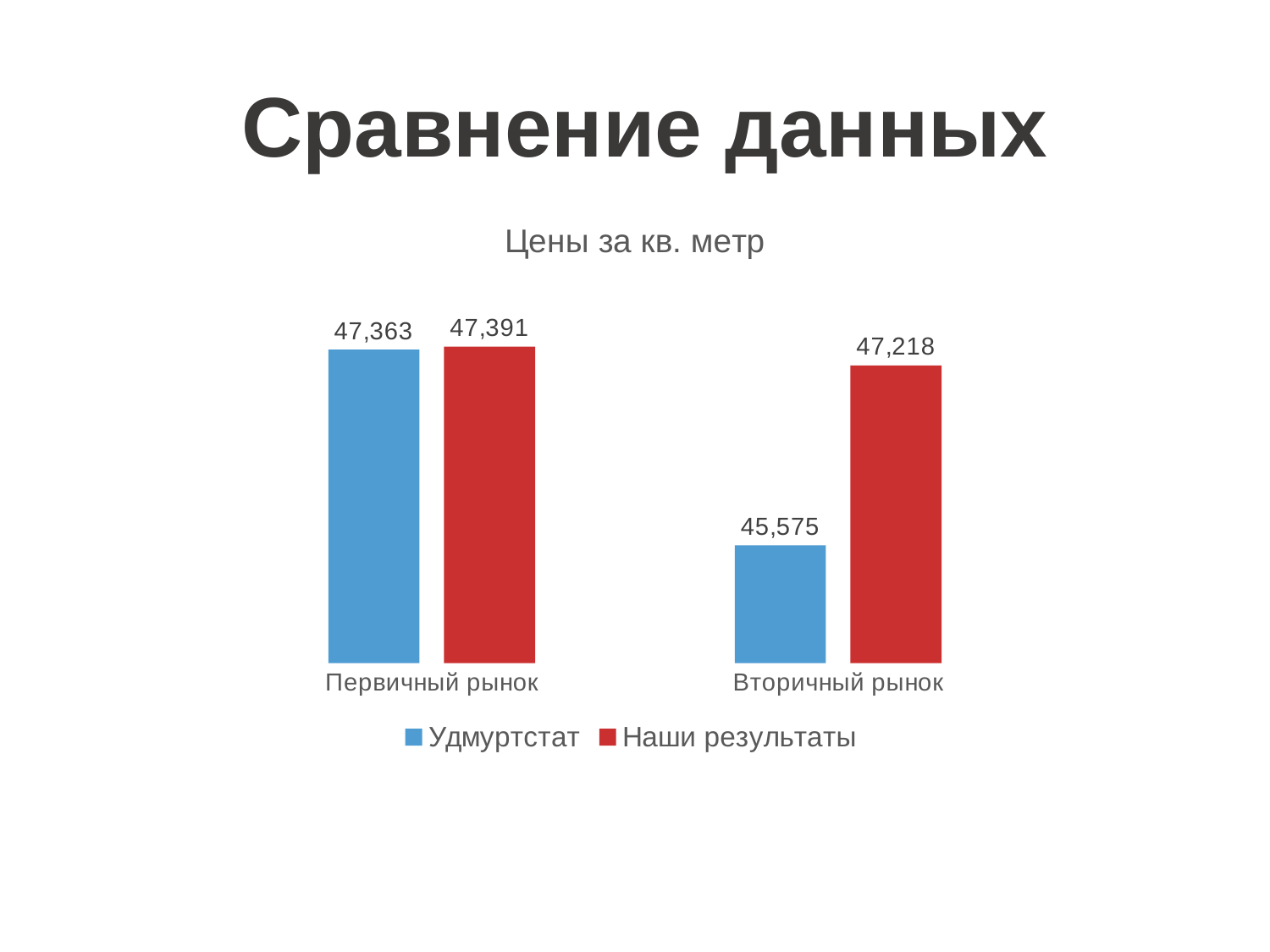
How many series does the legend list? 2 What is the value for Удмуртстат in the Вторичный рынок category? 45,575 Which bar has the lowest value on the chart? Удмуртстат, Вторичный рынок What type of chart is shown on the slide? Bar chart How many categories are shown on the x axis? 2 What is the value for Наши результаты in the Первичный рынок category? 47,391 What is the difference between Наши результаты and Удмуртстат in the Вторичный рынок category? 1,643 In the Вторичный рынок category, which series has the larger value, Удмуртстат or Наши результаты? Наши результаты What is the value for Удмуртстат in the Первичный рынок category? 47,363 What is the difference between the Удмуртстат values for Первичный рынок and Вторичный рынок? 1,788 What is the value for Наши результаты in the Вторичный рынок category? 47,218 What is the difference between Наши результаты and Удмуртстат in the Первичный рынок category? 28